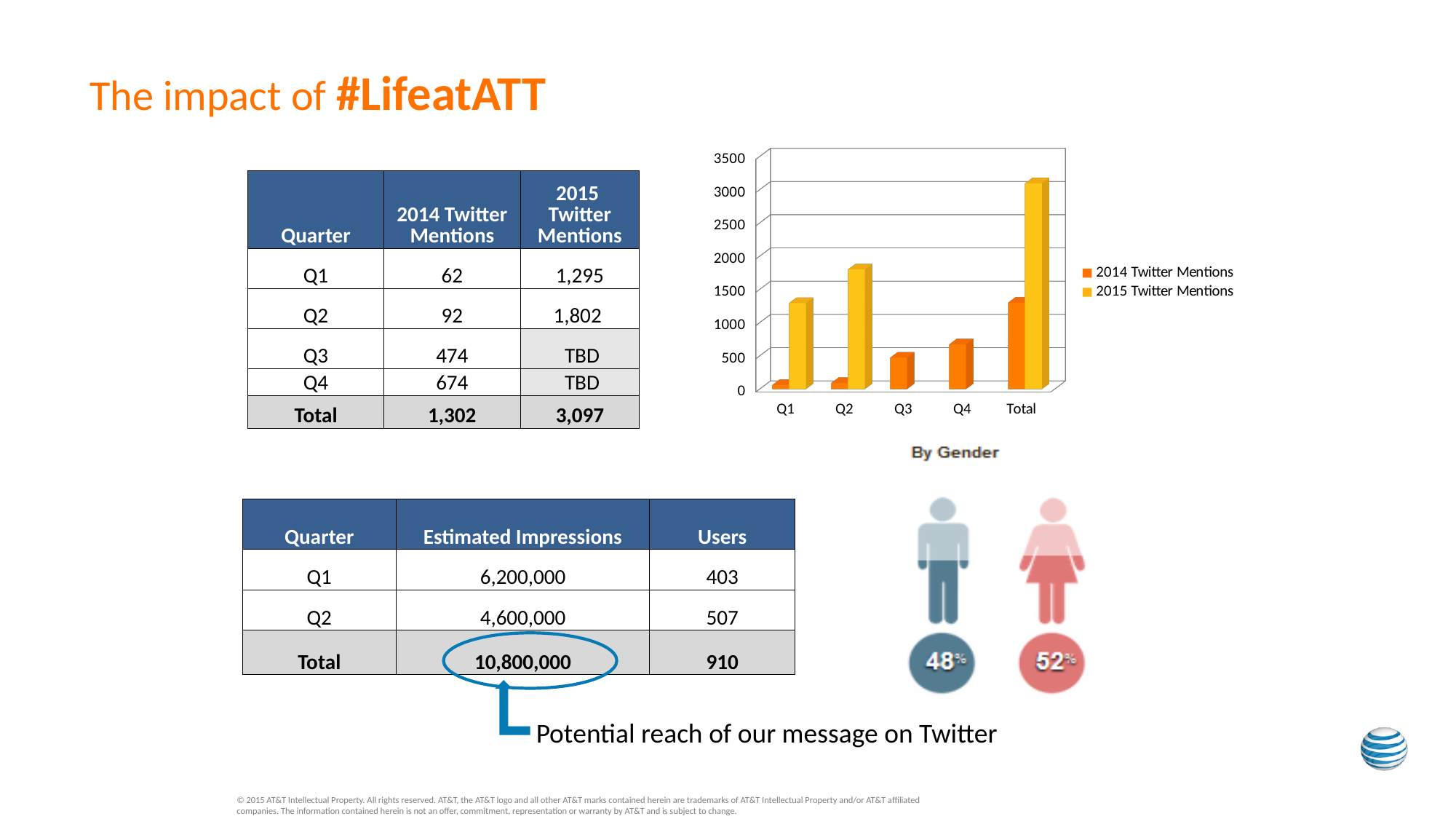
What is the 2014 Twitter Mentions value for Q3? 474 How many series does the chart's legend list? 2 Is the 2015 Twitter Mentions value for Q1 greater or less than 1000? greater Do the 2014 Twitter Mentions rise or fall from Q1 to Q4? Rise How many categories are shown on the x axis of the chart? 5 For Q2, which series has the larger value, 2014 Twitter Mentions or 2015 Twitter Mentions? 2015 Twitter Mentions Which colour represents 2015 Twitter Mentions in the chart? Yellow Is the 2014 Twitter Mentions value for Q4 greater or less than 1000? less Which category has the tallest 2015 Twitter Mentions bar? Total Which quarter has the lowest 2014 Twitter Mentions bar? Q1 What kind of chart is shown on the slide? Bar chart What is the difference between the 2015 and 2014 Twitter Mentions totals? 1,795